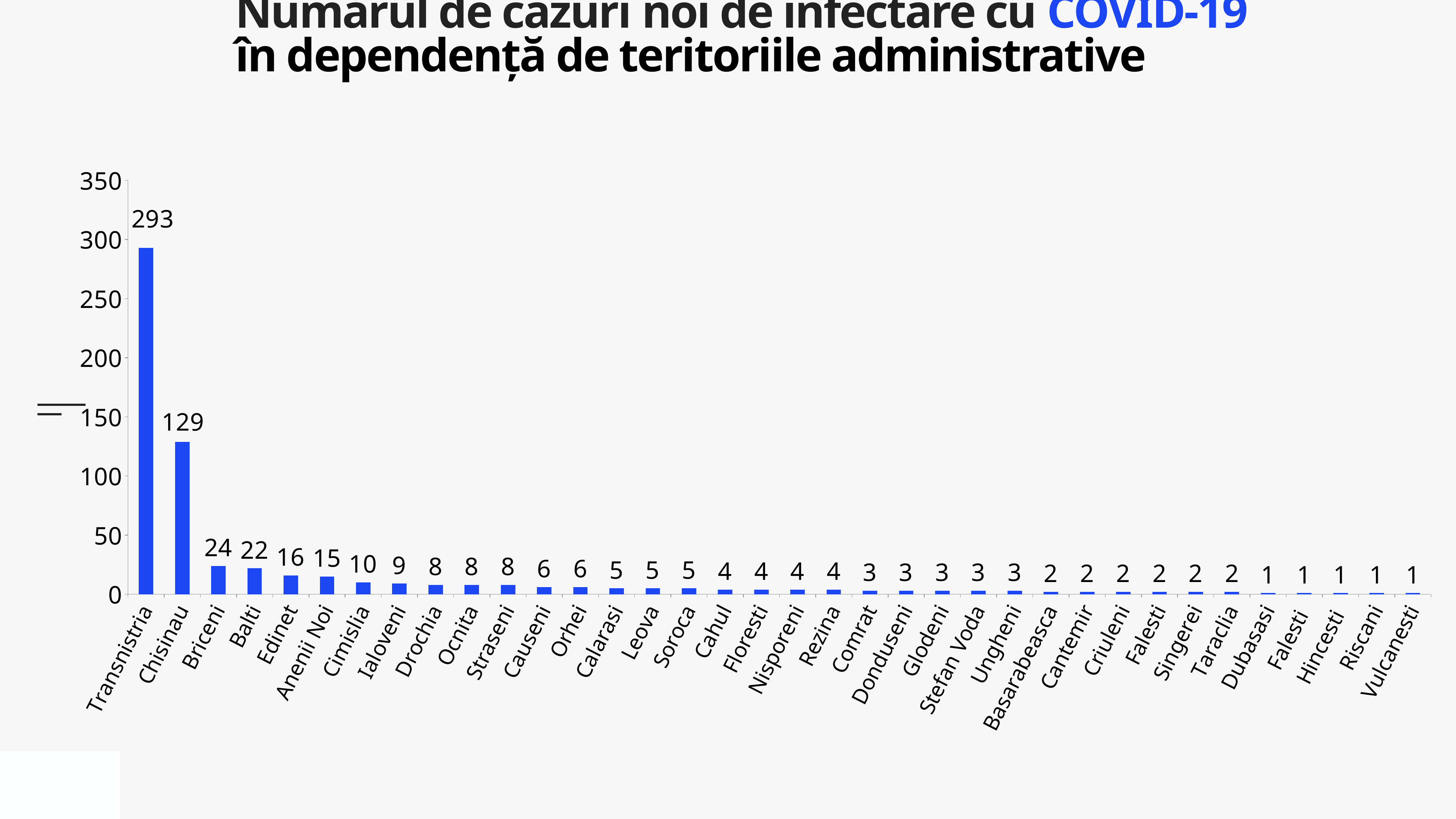
What kind of chart is shown on the slide? bar chart How many territories are shown on the x axis? 36 What is the difference between the values for Transnistria and Chisinau? 164 Which territory has the highest number of new cases? Transnistria What is the value for Edinet? 16 What is the value for Cimislia? 10 Is the value for Chisinau greater or less than 100? greater Which is larger, the value for Anenii Noi or the value for Ialoveni? Anenii Noi What is the value for Briceni? 24 What is the value for Chisinau? 129 What is the value for Transnistria? 293 What is the difference between the values for Briceni and Balti? 2